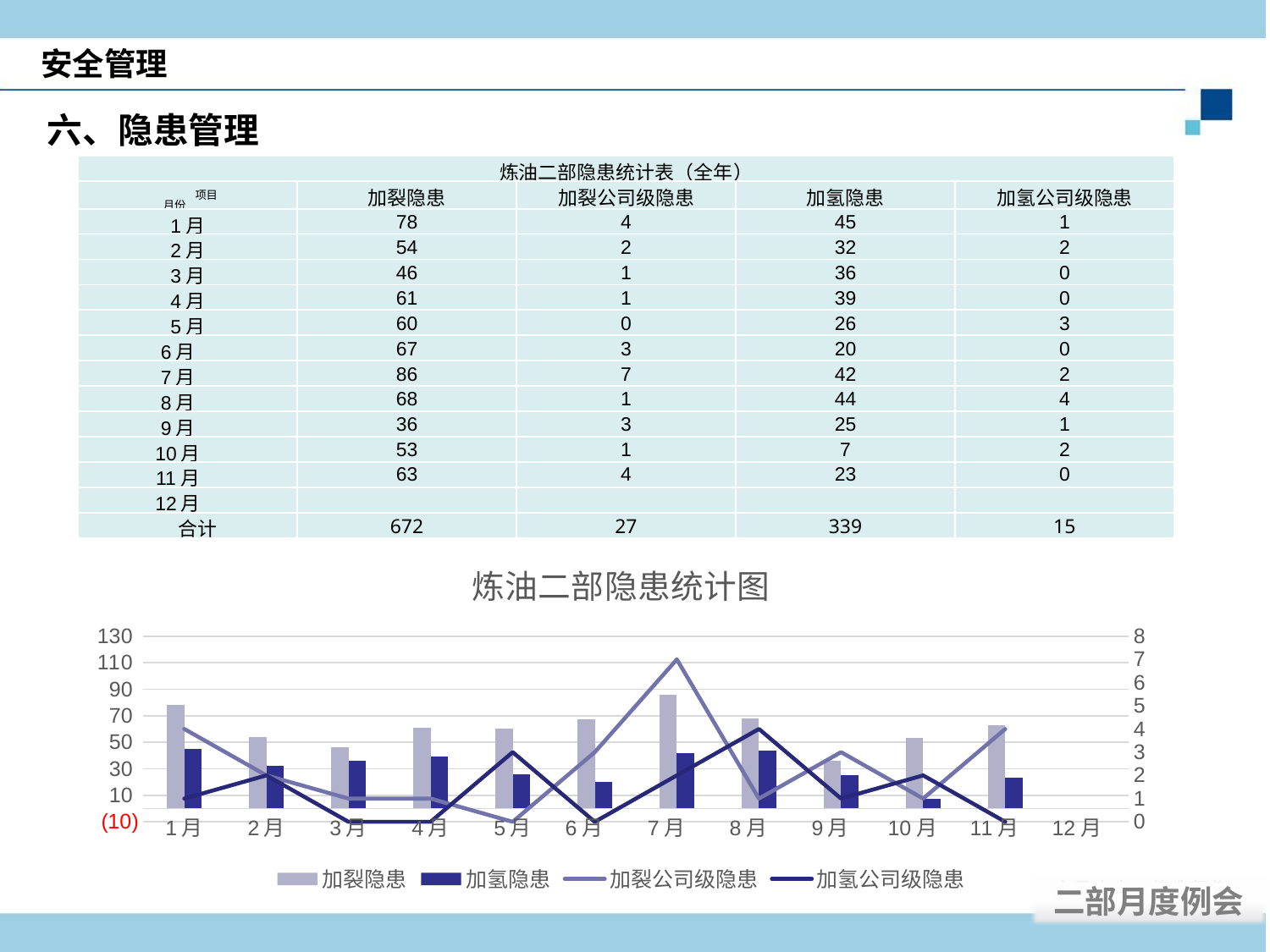
In the 炼油二部隐患统计图, which month has the highest 加裂隐患 bar? 7月 In the 炼油二部隐患统计图, which is larger for 4月: the 加裂隐患 bar or the 加氢隐患 bar? 加裂隐患 In the 炼油二部隐患统计图, which month has the highest point on the 加裂公司级隐患 line? 7月 In the 炼油二部隐患统计图, is the 加氢隐患 value for 10月 greater or less than 10? less In the 炼油二部隐患统计图, does the 加裂公司级隐患 line rise or fall from 5月 to 7月? rise How many series does the legend of the 炼油二部隐患统计图 list? 4 What is the difference between the 加裂隐患 values for 7月 and 9月? 50 In the 炼油二部隐患统计图, which month has the lowest 加氢隐患 bar? 10月 What is the 加裂隐患 value for 7月 shown on the slide? 86 In the 炼油二部隐患统计图, is the 加裂隐患 value for 7月 greater or less than 70? greater What kind of chart is the 炼油二部隐患统计图? Combined bar and line chart How many month categories are shown on the x axis of the 炼油二部隐患统计图? 12